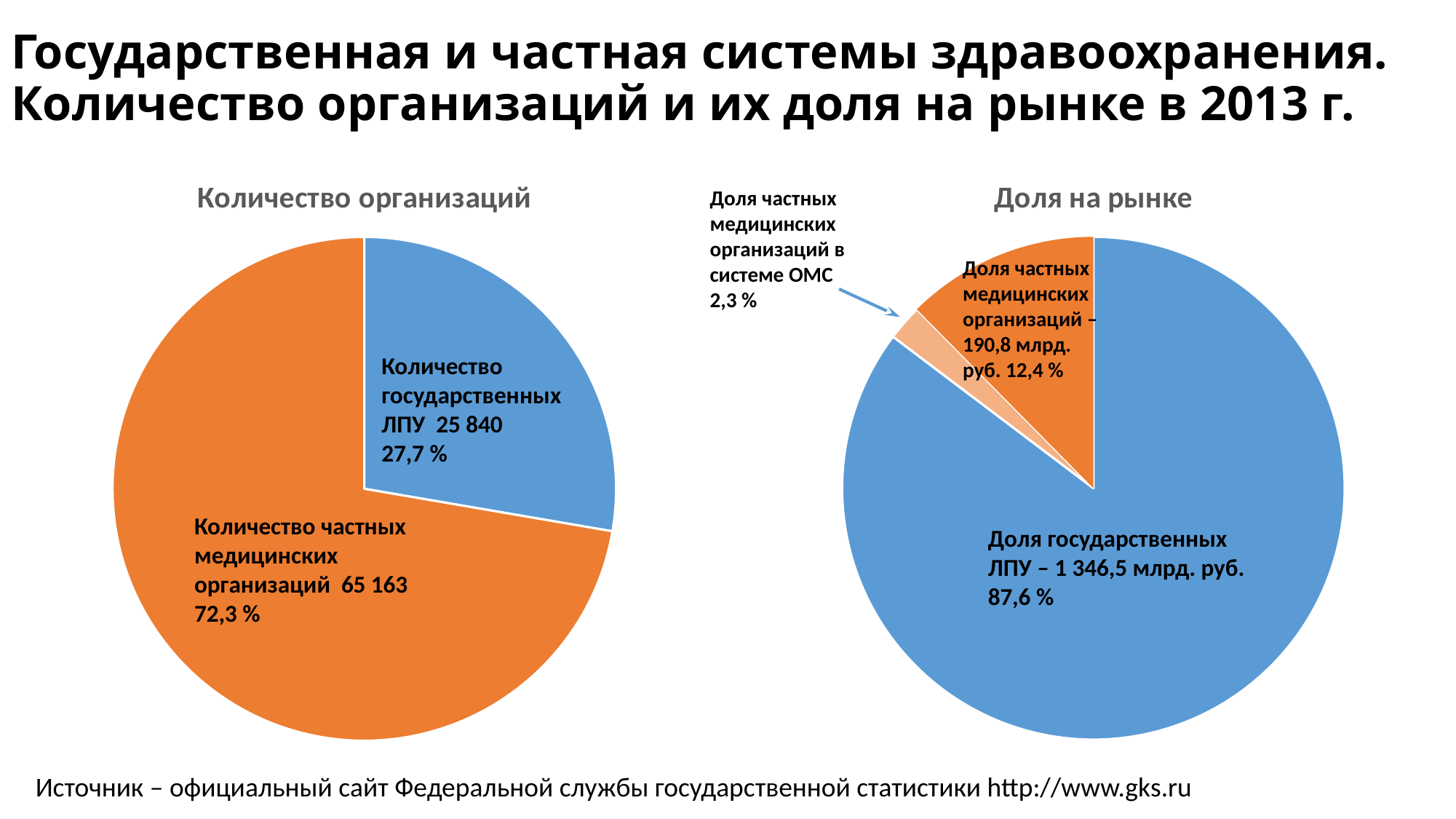
In the "Доля на рынке" chart, what is the market value for state LPU? 1 346,5 млрд. руб. In the "Количество организаций" chart, what share of the pie do state LPU hold? 27,7 % What type of chart is the "Количество организаций" chart? pie chart In the "Доля на рынке" chart, which category has the smallest slice? Доля частных медицинских организаций в системе ОМС In the "Доля на рынке" chart, what is the market value for private medical organizations? 190,8 млрд. руб. In the "Доля на рынке" chart, what share of the market do private medical organizations in the OMS system hold? 2,3 % In the "Количество организаций" chart, which category has the larger slice? Количество частных медицинских организаций In the "Количество организаций" chart, what share of the pie do private medical organizations hold? 72,3 % How many pie charts are shown on the slide? 2 In the "Количество организаций" chart, how many state LPU (государственных ЛПУ) are there? 25 840 In the "Количество организаций" chart, how many private medical organizations are there? 65 163 In the "Количество организаций" chart, what is the difference between the number of private medical organizations and the number of state LPU? 39 323